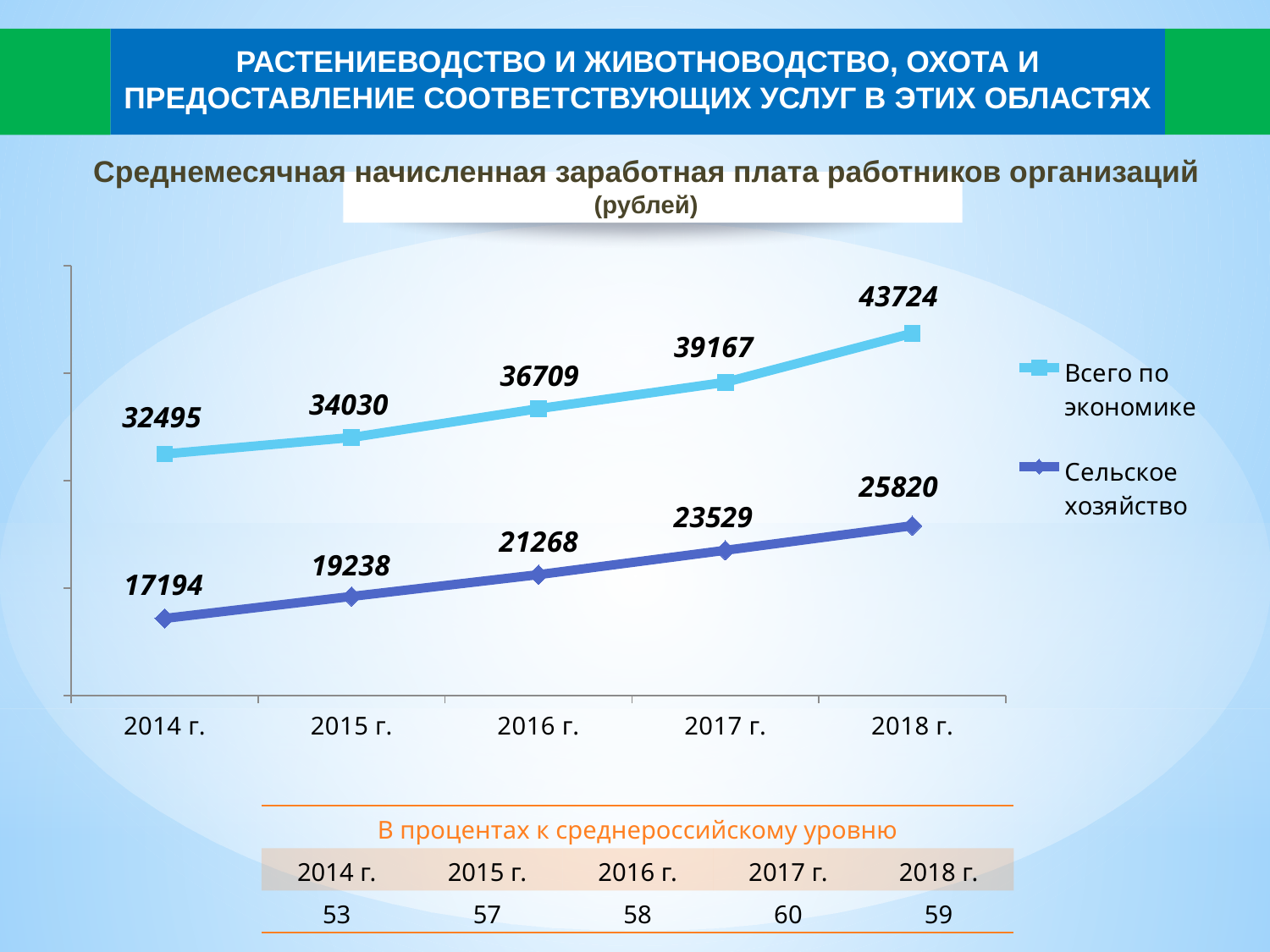
Do the values for "Сельское хозяйство" rise or fall from 2014 г. to 2018 г.? rise Which is larger in 2015 г.: the value for "Всего по экономике" or for "Сельское хозяйство"? Всего по экономике How many series does the chart legend list? 2 What type of chart is shown on the slide? line chart What is the difference between "Всего по экономике" and "Сельское хозяйство" in 2018 г.? 17904 How many years are plotted along the x axis of the chart? 5 What unit is given in parentheses under the chart title? рублей What is the value for "Сельское хозяйство" in 2014 г.? 17194 What is the value for "Всего по экономике" in 2016 г.? 36709 In which year is the value for "Сельское хозяйство" lowest? 2014 г. What is the value for "Сельское хозяйство" in 2018 г.? 25820 In which year is the value for "Всего по экономике" highest? 2018 г.